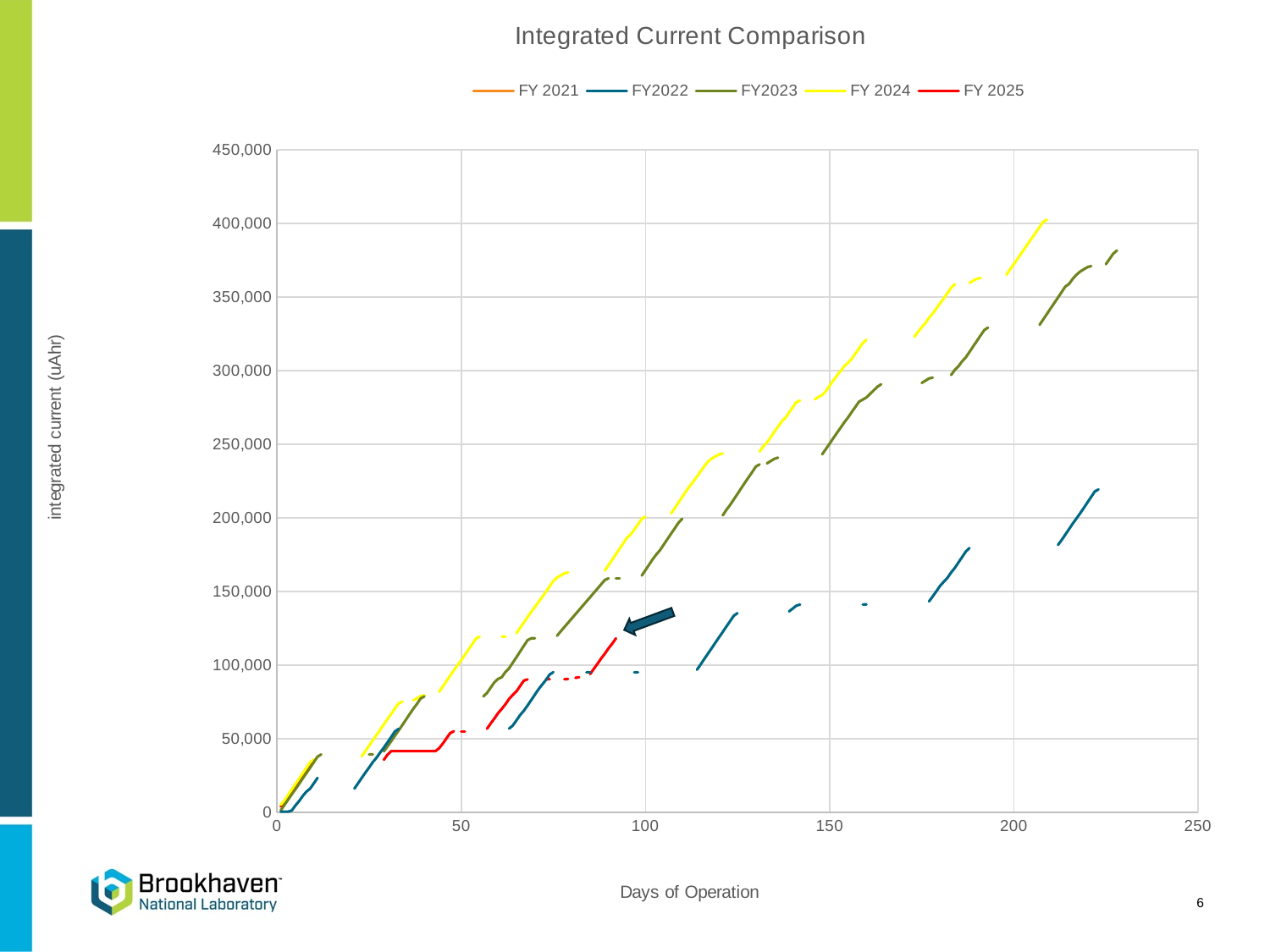
Do the integrated current values rise or fall as days of operation increase? rise Which series reaches the highest integrated current on the chart? FY 2024 Is the final value for FY 2025 greater or less than 100,000? greater What is the label of the vertical axis? integrated current (uAhr) Is the value for FY 2024 at 150 days of operation greater or less than 250,000? greater What kind of chart is shown on the slide? line chart What is the title of the chart? Integrated Current Comparison At 150 days of operation, which series has the larger integrated current, FY 2024 or FY2023? FY 2024 Is the value for FY2022 at 220 days of operation greater or less than 200,000? greater How many series does the legend list? 5